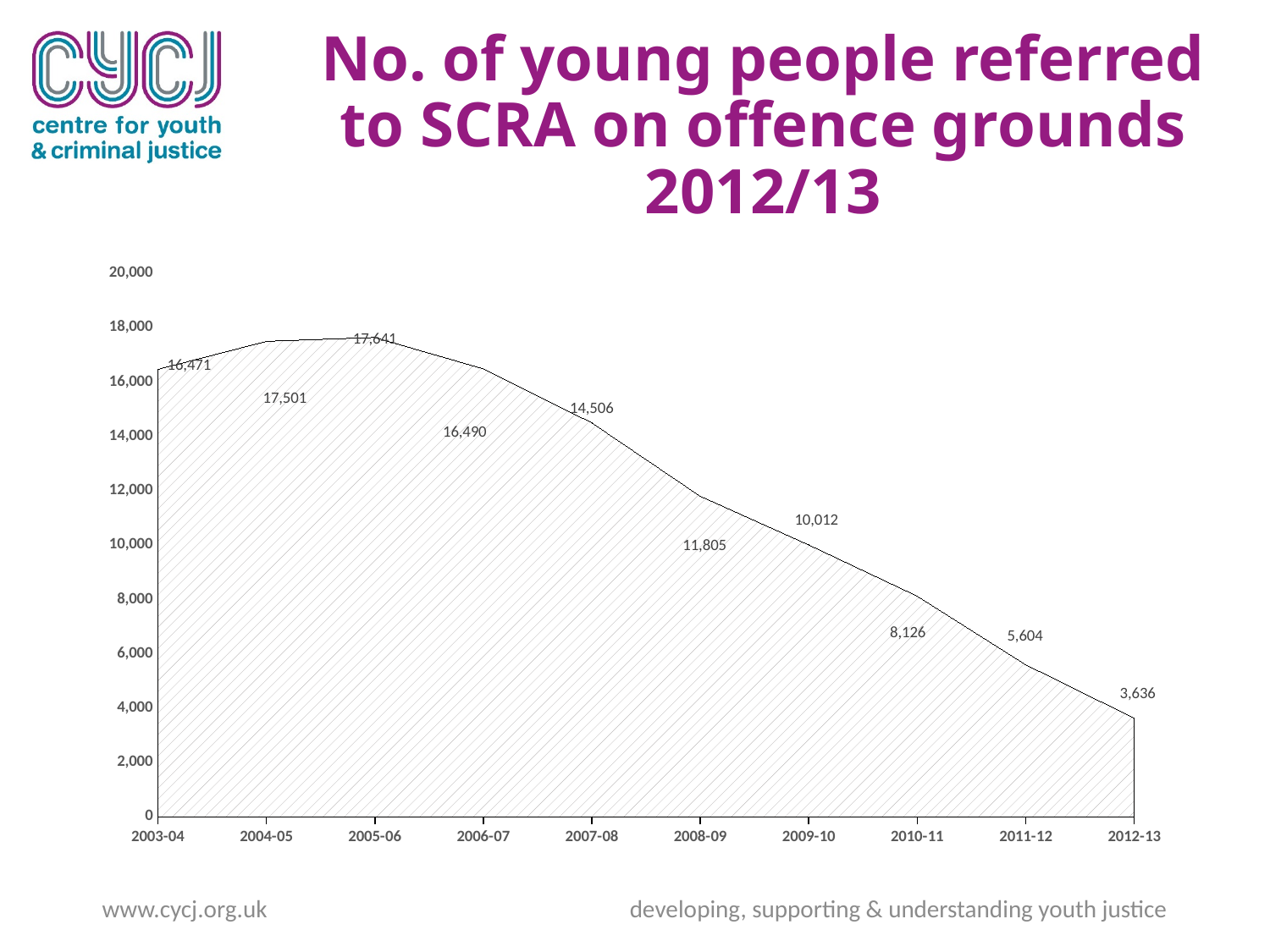
What is the number of young people referred in 2003-04? 16,471 What is the value for 2008-09? 11,805 Which is larger, the value for 2006-07 or the value for 2007-08? 2006-07 What kind of chart is shown on the slide? Area chart What is the value for 2012-13? 3,636 How many years are plotted on the x axis? 10 What is the difference between the values for 2009-10 and 2010-11? 1,886 What is the title of the chart? No. of young people referred to SCRA on offence grounds 2012/13 Which year has the highest number of referrals? 2005-06 What is the difference between the values for 2005-06 and 2012-13? 14,005 Which year has the lowest number of referrals? 2012-13 Do the values generally rise or fall from 2005-06 to 2012-13? Fall